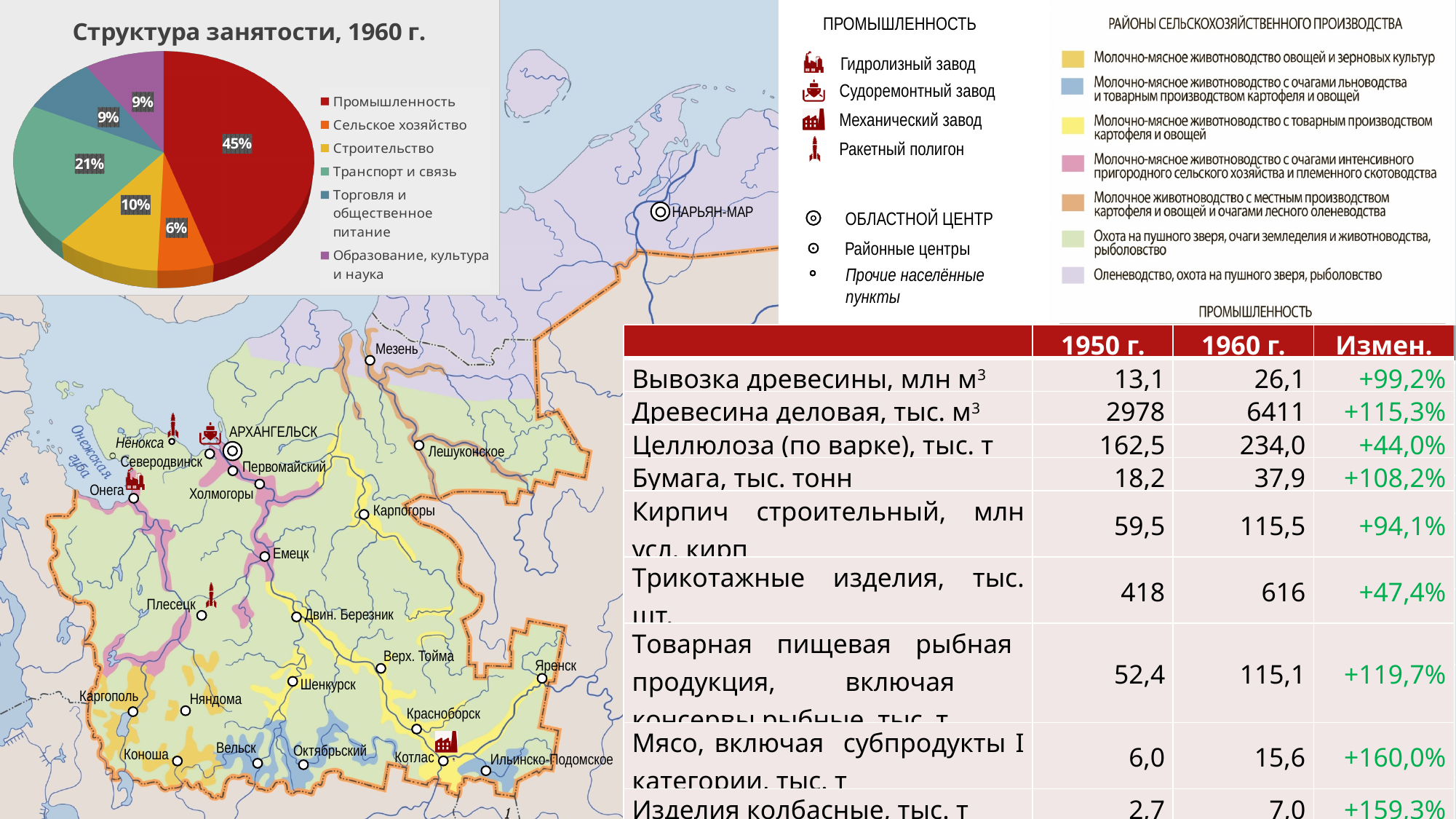
What kind of chart is shown in the top-left of the slide? pie chart In the pie chart, what share does Сельское хозяйство have? 6% What is the title of the pie chart on the slide? Структура занятости, 1960 г. In the pie chart, what share does Промышленность have? 45% In the pie chart, what is the difference in percentage points between Промышленность and Транспорт и связь? 24 Which category has the smallest slice in the pie chart? Сельское хозяйство In the pie chart, which is larger: Строительство or Сельское хозяйство? Строительство In the pie chart, what share does Строительство have? 10% Which category has the largest slice in the pie chart? Промышленность How many categories does the pie chart legend list? 6 In the pie chart, what share does Транспорт и связь have? 21% In the pie chart, what share does Торговля и общественное питание have? 9%